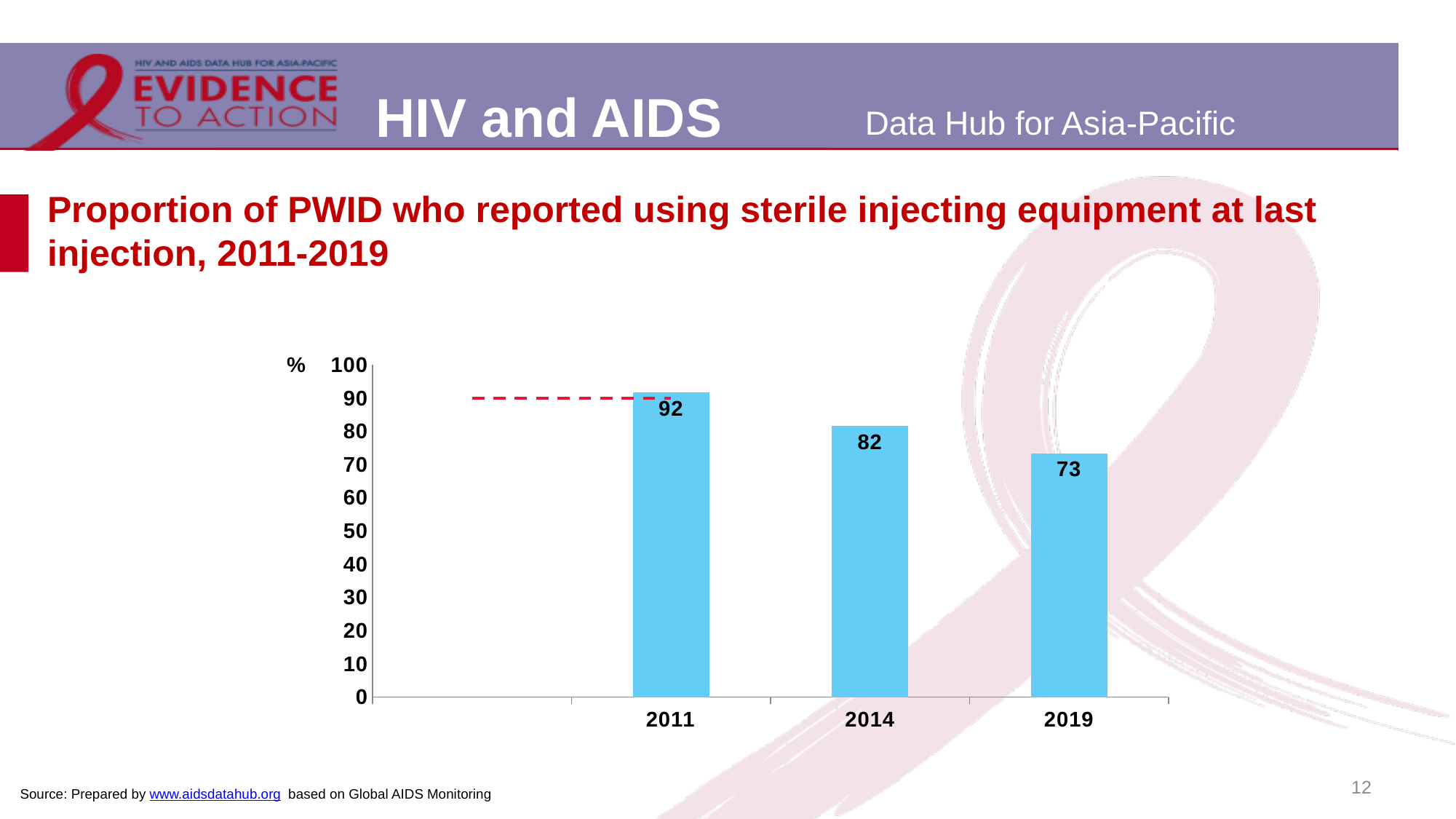
Do the values rise or fall from 2011 to 2019? fall Which year has the highest value? 2011 What is the value for 2019? 73 What kind of chart is shown on the slide? bar chart Which is larger, the value for 2011 or the value for 2014? 2011 How many years are shown on the x axis? 3 Which year has the lowest value? 2019 What is the value for 2011? 92 What is the difference between the values for 2011 and 2019? 19 What is the value for 2014? 82 Is the value for 2019 greater or less than 80? less What is the difference between the values for 2014 and 2019? 9